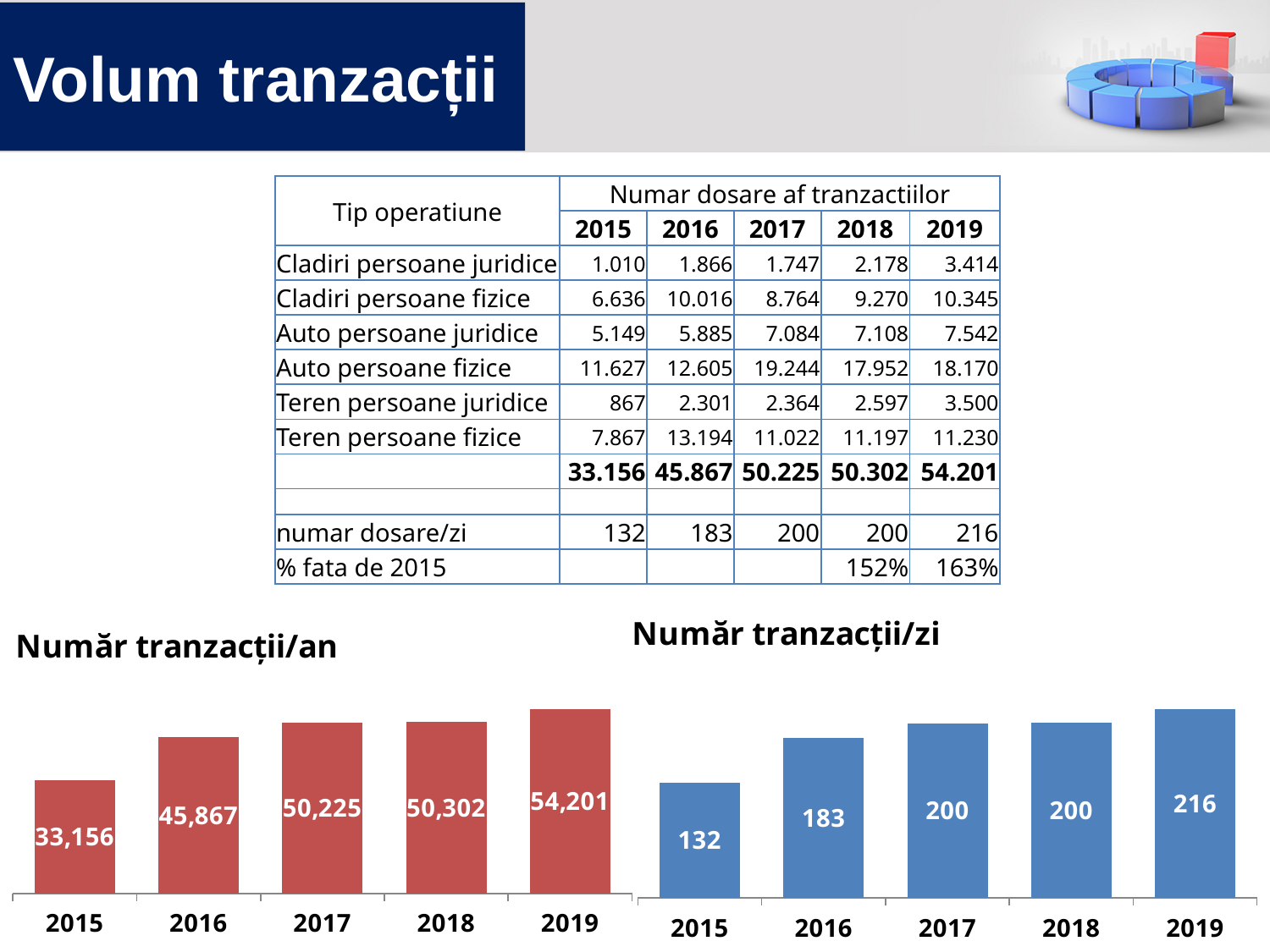
In the 'Număr tranzacții/an' chart, what is the value for 2019? 54,201 In the 'Număr tranzacții/zi' chart, what is the value for 2016? 183 In the 'Număr tranzacții/an' chart, what is the value for 2015? 33,156 In the 'Număr tranzacții/an' chart, what is the difference between the values for 2019 and 2015? 21,045 In the 'Număr tranzacții/an' chart, which is larger, the value for 2016 or the value for 2017? 2017 How many bars are in the 'Număr tranzacții/zi' chart? 5 What kind of chart is the 'Număr tranzacții/an' chart? bar chart In the 'Număr tranzacții/zi' chart, which year has the highest value? 2019 In the 'Număr tranzacții/an' chart, which year has the lowest value? 2015 What colour are the bars in the 'Număr tranzacții/an' chart? red In the 'Număr tranzacții/zi' chart, what is the difference between the values for 2019 and 2015? 84 In the 'Număr tranzacții/zi' chart, do the values generally rise or fall from 2015 to 2019? rise